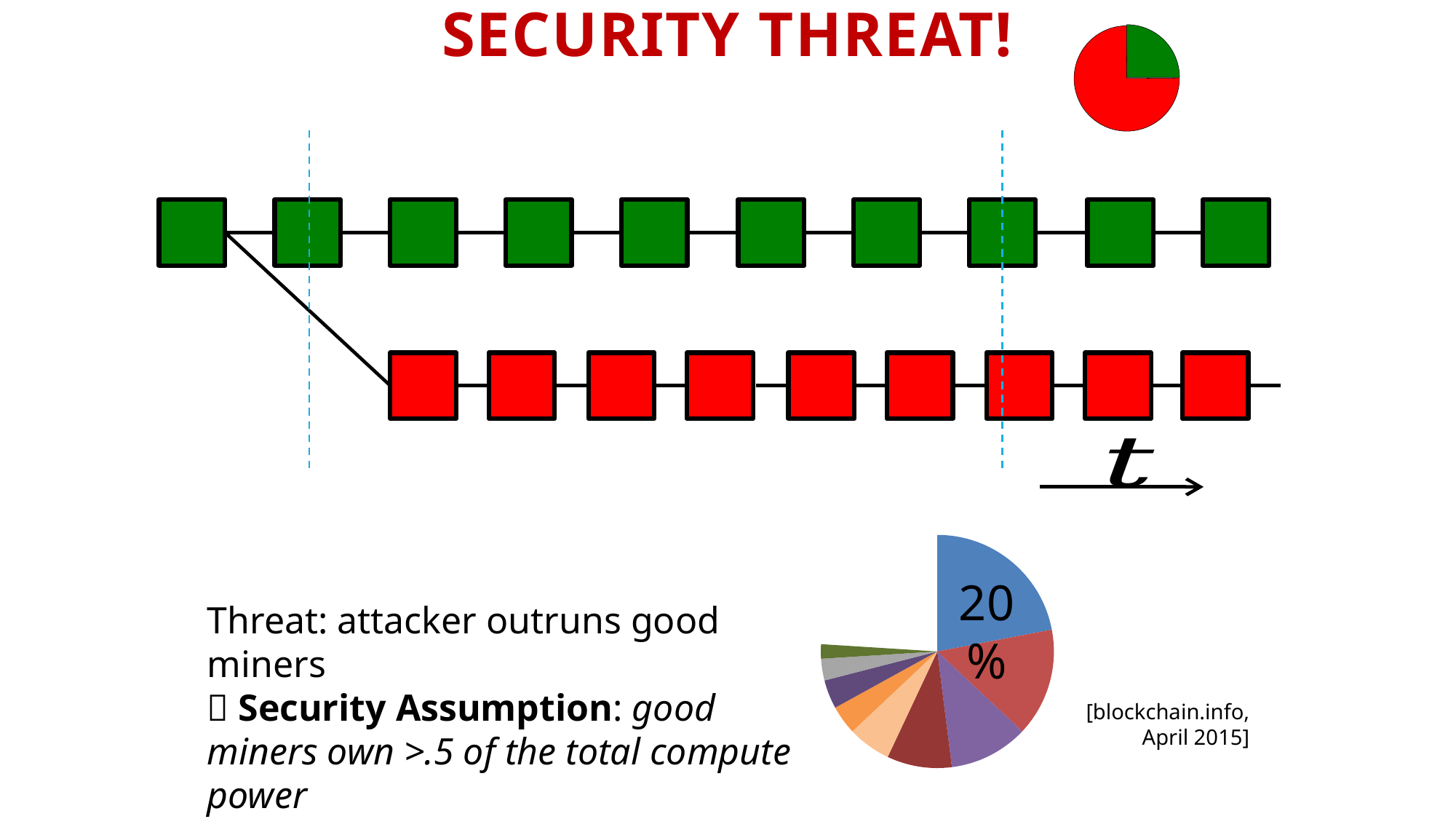
In the top-right pie chart, which slice is larger, the red one or the green one? red What kind of chart is shown at the top right of the slide, next to the title? pie chart How many slices does the bottom-right pie chart have? 10 What source and date are cited next to the bottom-right pie chart? blockchain.info, April 2015 What kind of chart is shown at the bottom right of the slide? pie chart In the bottom-right pie chart, what value is printed on the blue slice? 20% What two colours are used in the top-right pie chart? red and green How many slices does the top-right pie chart have? 2